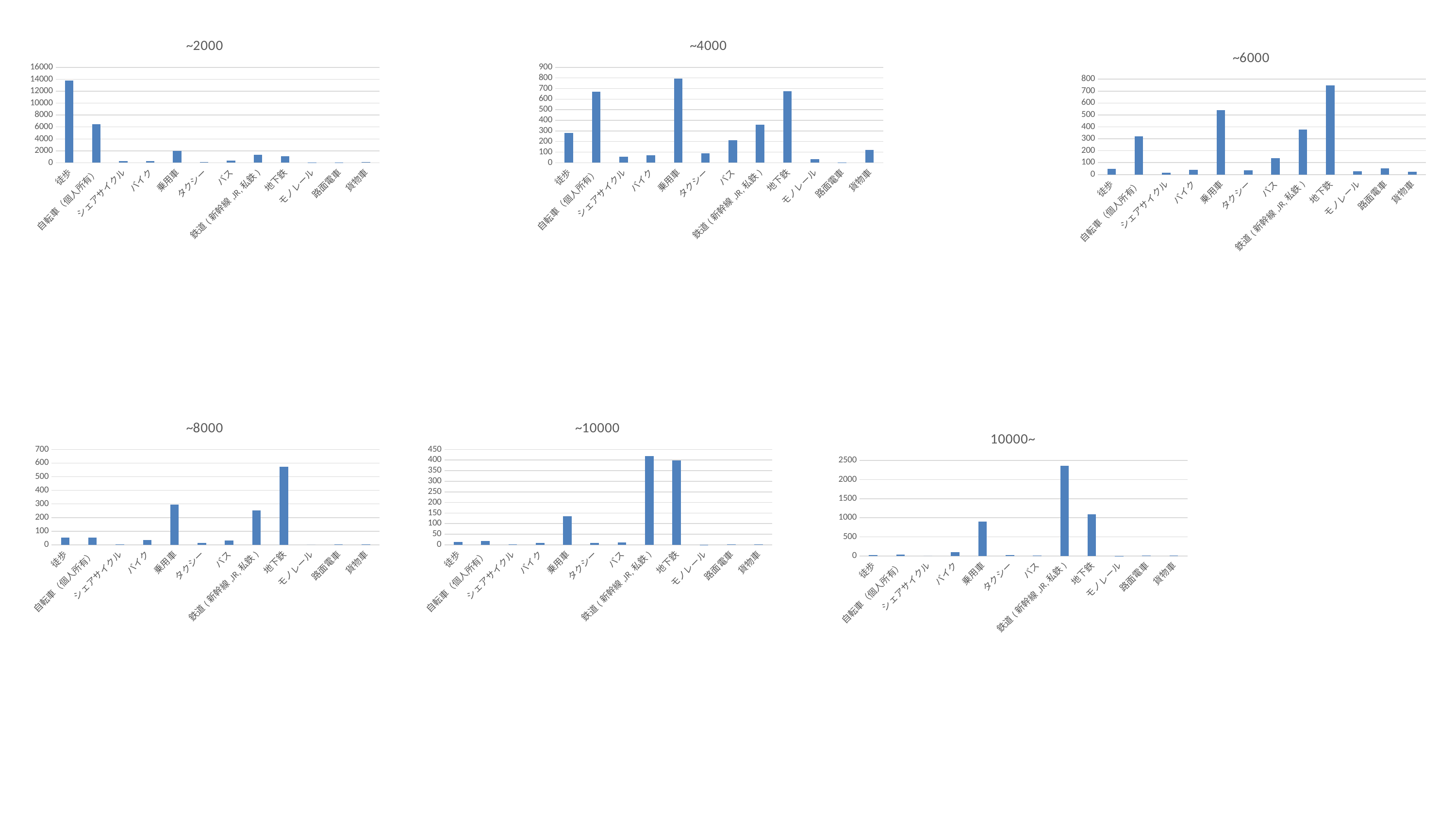
In the chart titled ~2000, is the value for 徒歩 greater or less than 12000? greater In the chart titled ~6000, which category has the highest value? 地下鉄 In the chart titled 10000~, which category has the highest value? 鉄道（新幹線,JR,私鉄） In the chart titled ~4000, which category has the highest value? 乗用車 In the chart titled ~10000, is the value for 乗用車 greater or less than 100? greater What kind of chart is the chart titled ~8000? bar chart In the chart titled ~4000, is the value for 徒歩 greater or less than 400? less In the chart titled ~6000, which is larger, the value for 乗用車 or the value for 鉄道（新幹線,JR,私鉄）? 乗用車 In the chart titled 10000~, how many categories are shown on the x axis? 12